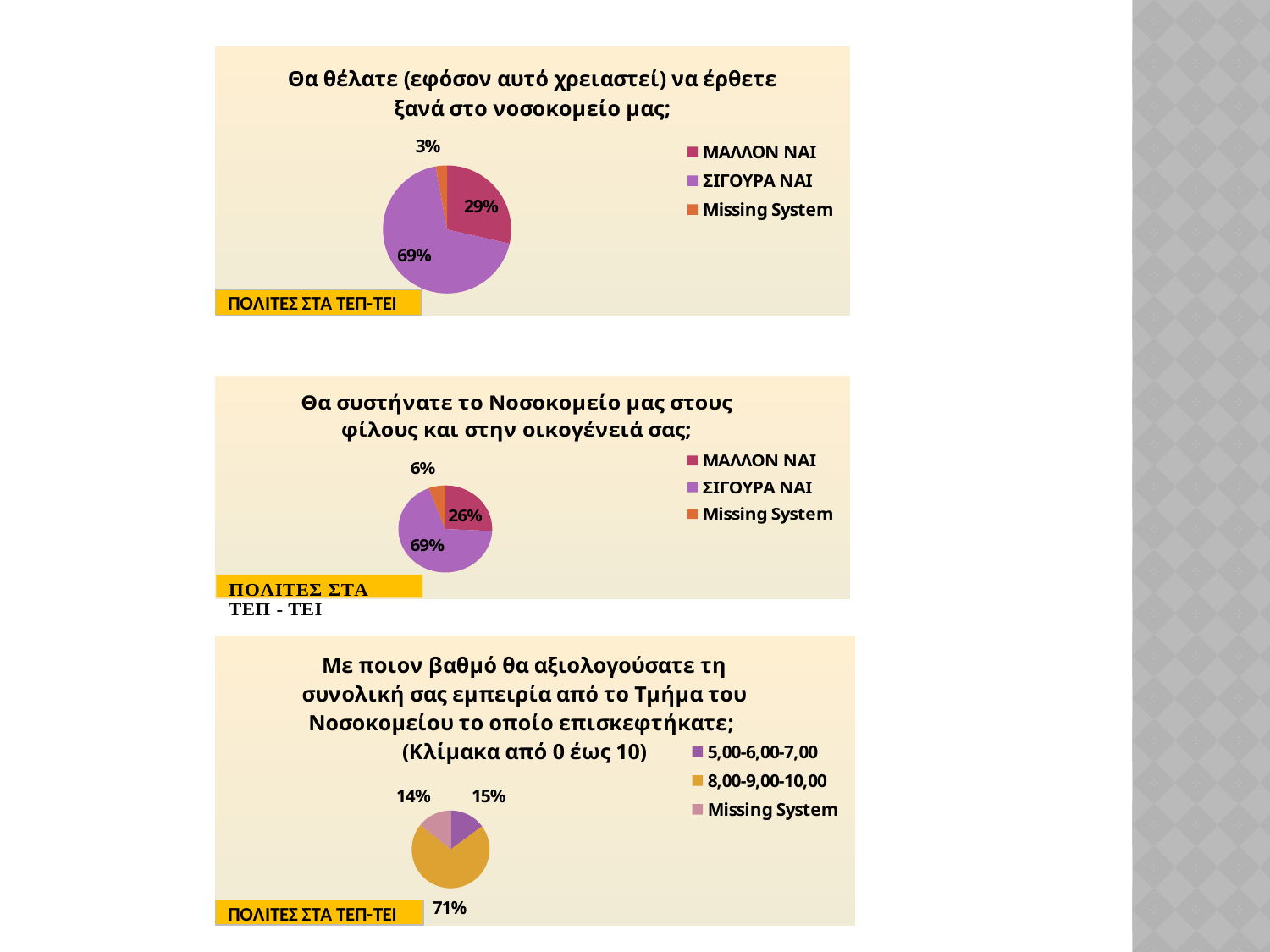
In the top pie chart, what share is labelled for ΣΙΓΟΥΡΑ ΝΑΙ? 69% How many charts are on the slide, and what type are they? 3 pie charts In the bottom pie chart, what share is labelled for 5,00-6,00-7,00? 15% In the middle pie chart, which category has the smallest slice? Missing System In the top pie chart, which category has the largest slice? ΣΙΓΟΥΡΑ ΝΑΙ In the bottom pie chart, which is larger: the slice for 5,00-6,00-7,00 or the slice for Missing System? 5,00-6,00-7,00 In the middle pie chart, what share is labelled for Missing System? 6% In the middle pie chart, what is the difference in percentage points between ΣΙΓΟΥΡΑ ΝΑΙ and ΜΑΛΛΟΝ ΝΑΙ? 43